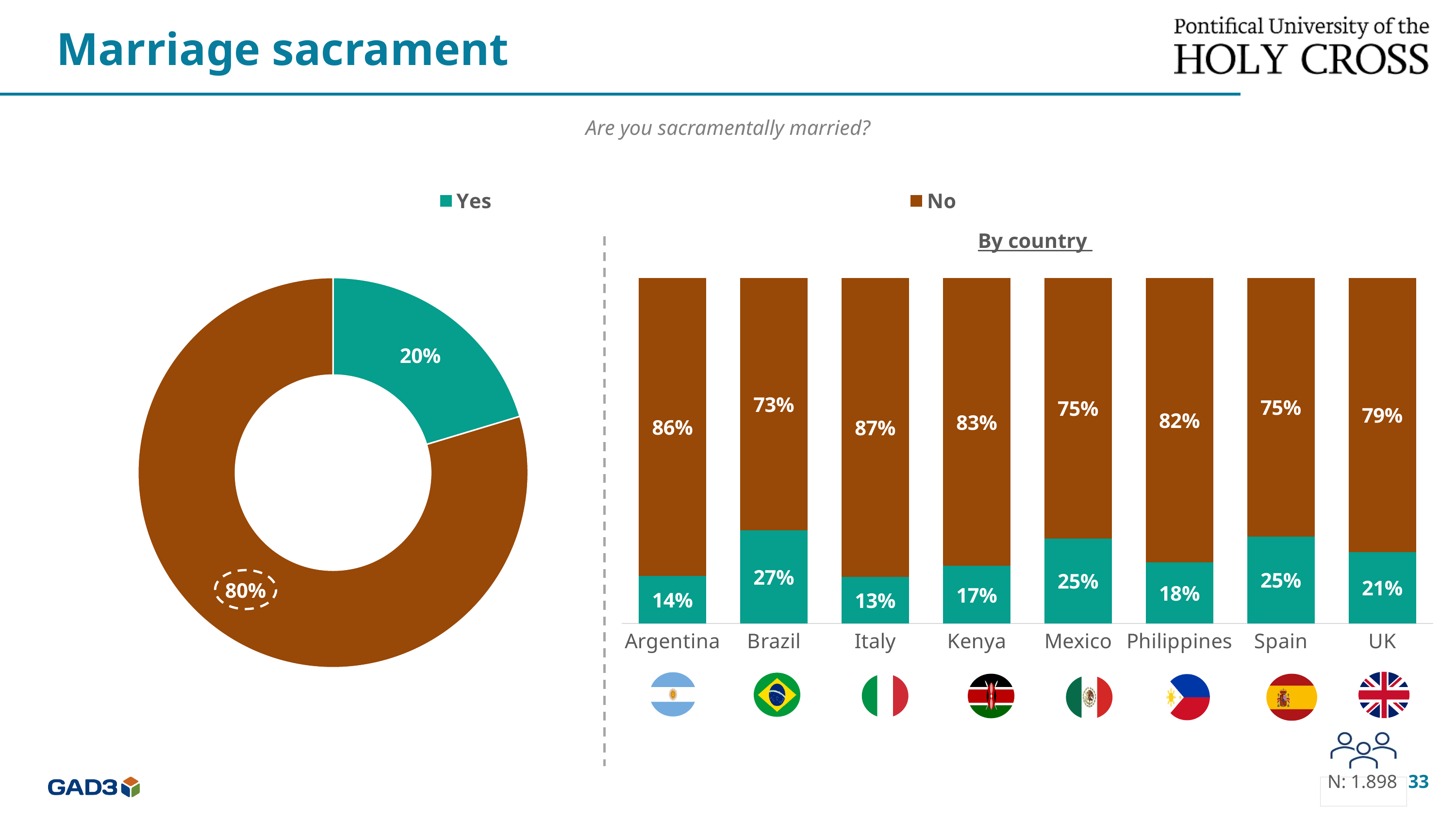
In the donut chart on the left, what share of respondents answered Yes? 20% In the 'By country' bar chart, what is the difference between the No values for Argentina and Brazil? 13% In the 'By country' bar chart, which country has the lowest Yes value? Italy What kind of chart is the 'By country' chart on the right? Stacked bar chart In the 'By country' bar chart, which country has the highest Yes value? Brazil In the donut chart on the left, what share of respondents answered No? 80% In the 'By country' bar chart, what is the total of the Yes and No values for Spain? 100% In the 'By country' bar chart, what is the No value for Italy? 87% In the 'By country' bar chart, what is the Yes value for Brazil? 27% How many series does the legend list? 2 How many countries are shown in the 'By country' bar chart? 8 In the 'By country' bar chart, which is larger: the Yes value for Kenya or the Yes value for UK? UK